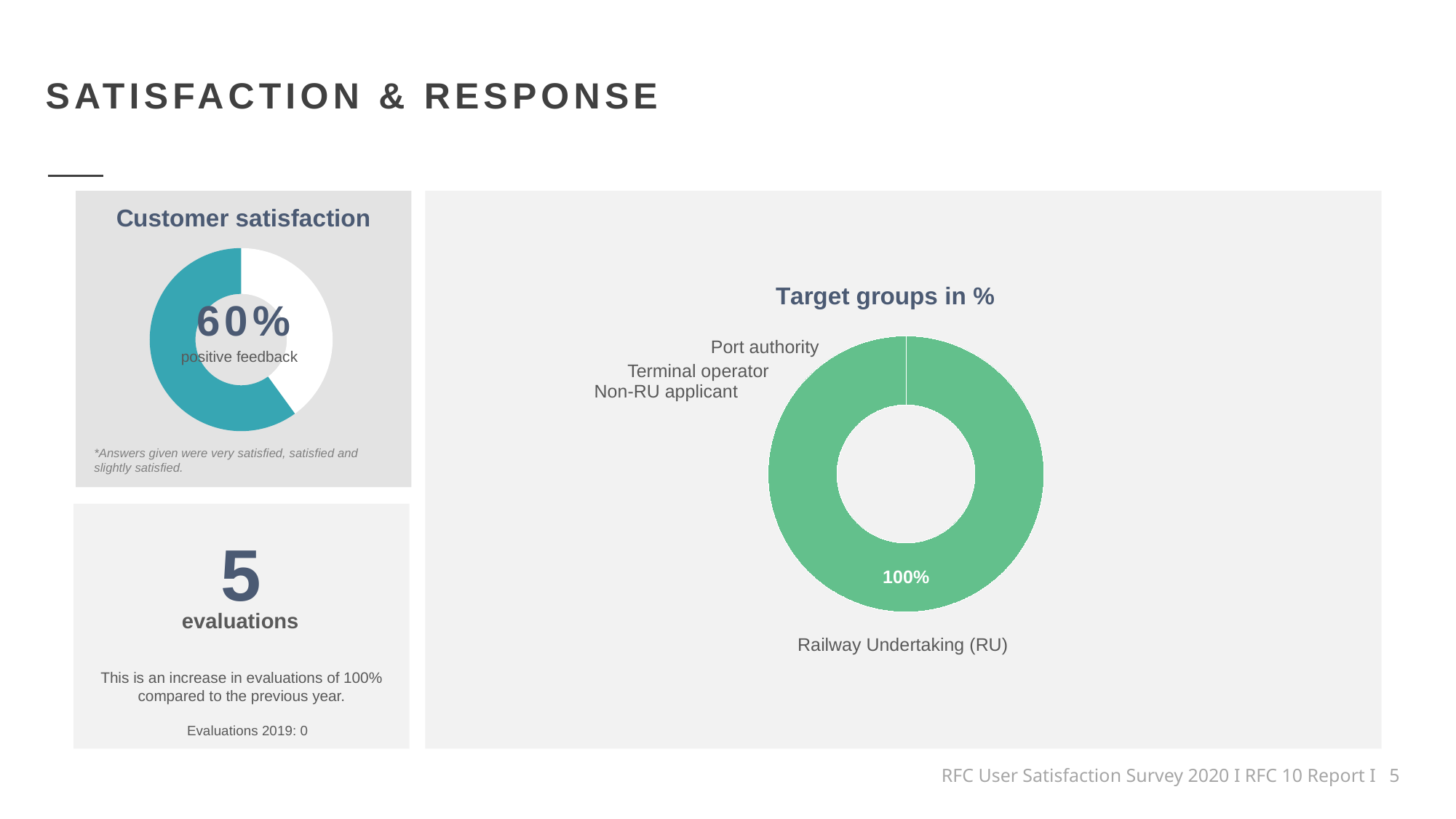
What colour is the filled segment of the 'Target groups in %' donut chart? Green In the 'Target groups in %' chart, which target group has the largest share? Railway Undertaking (RU) What kind of chart is the 'Target groups in %' chart? Donut (pie) chart What kind of chart is the 'Customer satisfaction' chart? Donut (pie) chart In the 'Target groups in %' chart, what share of the donut does the Railway Undertaking (RU) slice take up? 100% In the 'Target groups in %' chart, which is larger: the share for Railway Undertaking (RU) or the share for Port authority? Railway Undertaking (RU) In the 'Target groups in %' chart, what share is shown for Railway Undertaking (RU)? 100% In the 'Customer satisfaction' chart, is the positive feedback share greater or less than 50%? greater How many target group categories are labelled in the 'Target groups in %' chart? 4 What is the title of the chart on the right side of the slide? Target groups in % In the 'Customer satisfaction' chart, what percentage of feedback was positive? 60%